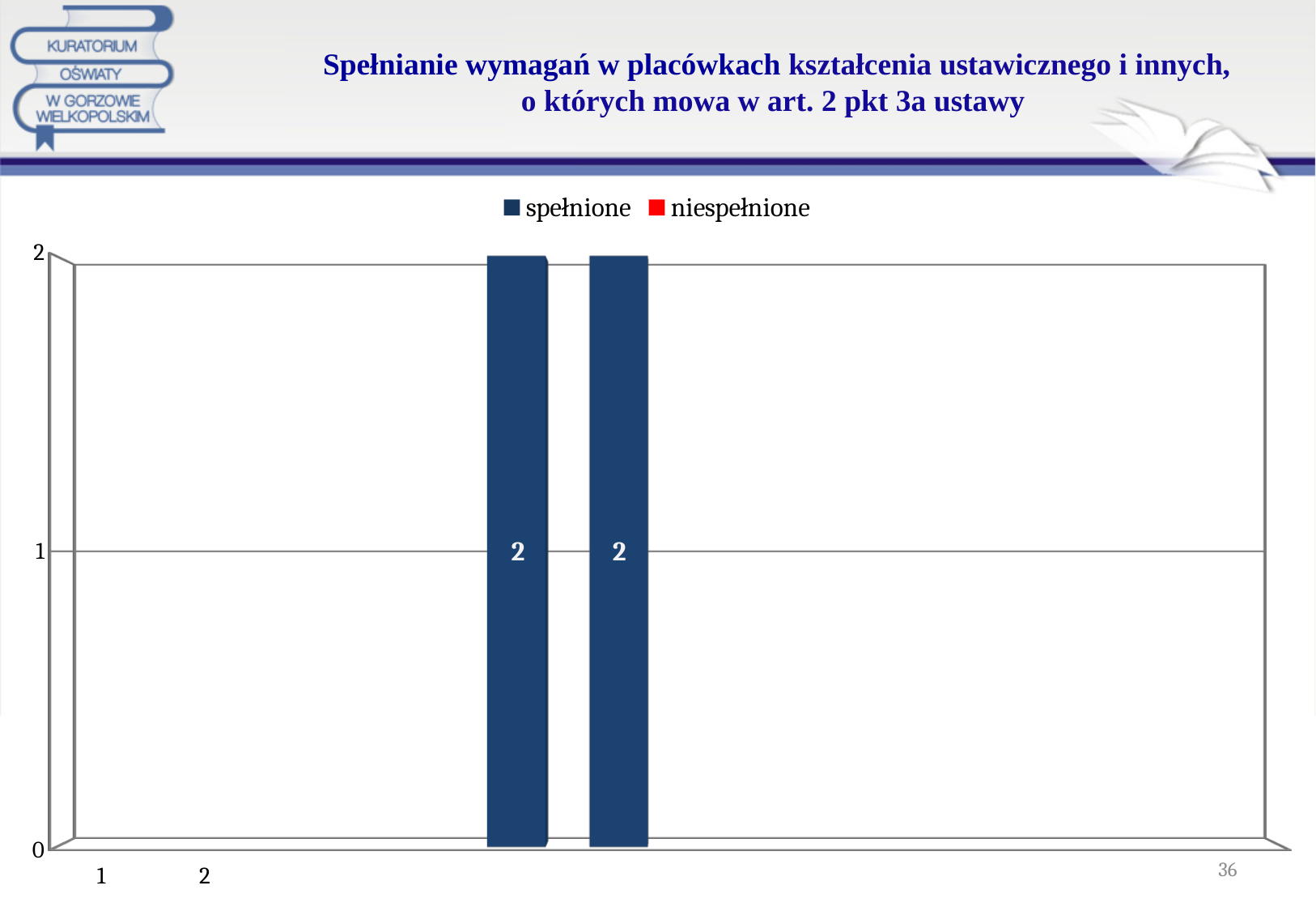
How many series does the legend list? 2 What value is printed on the left bar? 2 What kind of chart is shown on the slide? bar chart What are the two series named in the legend? spełnione, niespełnione What value is printed on the right bar? 2 What is the highest value shown on the vertical axis? 2 Is the left bar larger, smaller, or equal to the right bar? equal What is the difference between the values of the two bars? 0 Is the value of the left bar greater or less than 1? greater Which series do the plotted bars belong to? spełnione How many bars are plotted on the chart? 2 What are the category labels shown on the horizontal axis? 1, 2